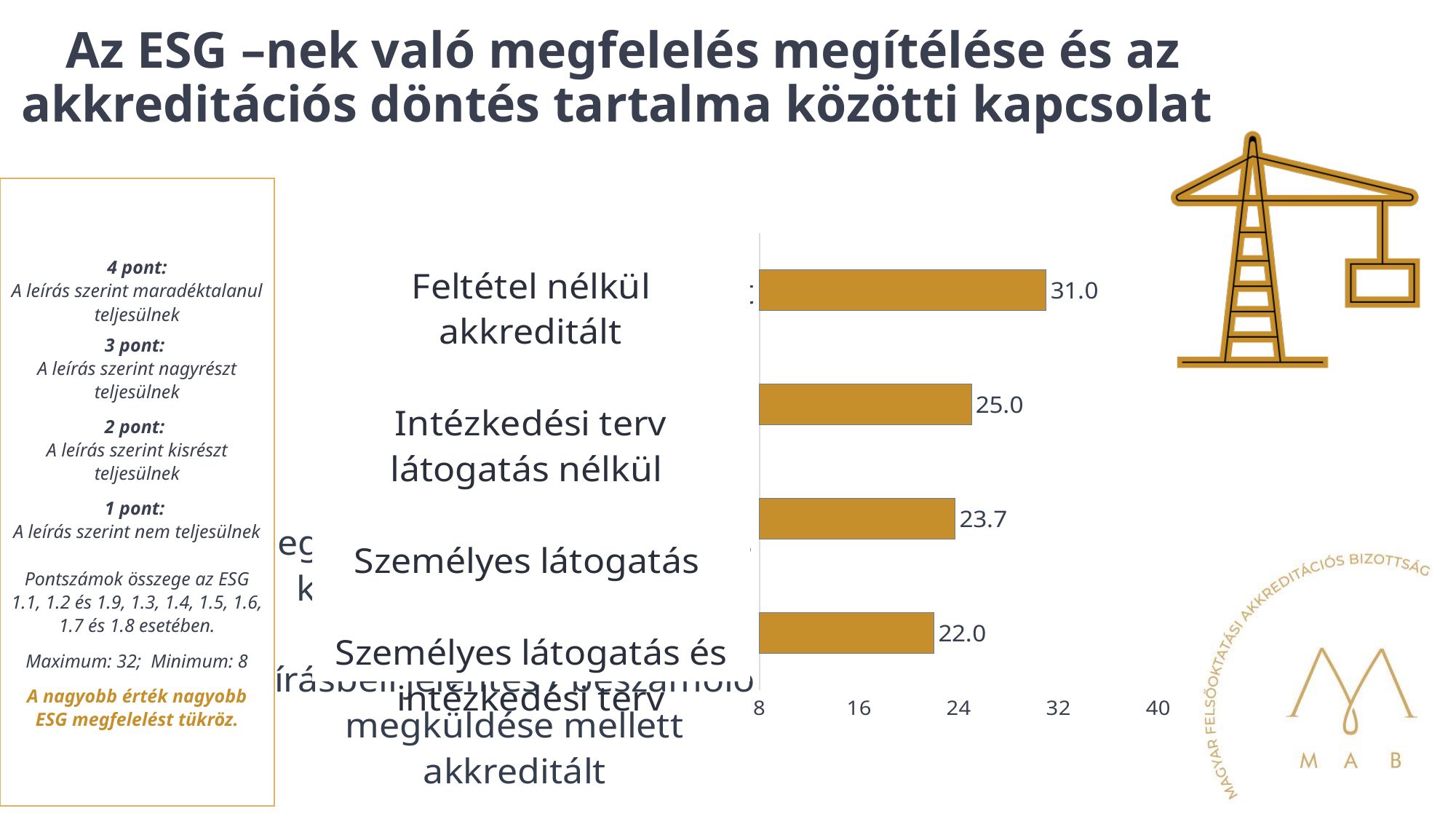
What is the value for "Személyes látogatás és intézkedési terv megküldése mellett akkreditált"? 22.0 Which is larger, the value for "Intézkedési terv látogatás nélkül" or the value for "Személyes látogatás"? Intézkedési terv látogatás nélkül What is the difference between the values for "Feltétel nélkül akkreditált" and "Intézkedési terv látogatás nélkül"? 6.0 Which category has the lowest value? Személyes látogatás és intézkedési terv megküldése mellett akkreditált Which category has the highest value? Feltétel nélkül akkreditált What is the value for "Feltétel nélkül akkreditált"? 31.0 Is the value for "Feltétel nélkül akkreditált" greater or less than 32? less What is the value for "Intézkedési terv látogatás nélkül"? 25.0 What is the difference between the values for "Személyes látogatás" and "Személyes látogatás és intézkedési terv megküldése mellett akkreditált"? 1.7 What kind of chart is shown on the slide? bar chart What is the value for "Személyes látogatás"? 23.7 How many categories are shown in the bar chart? 4